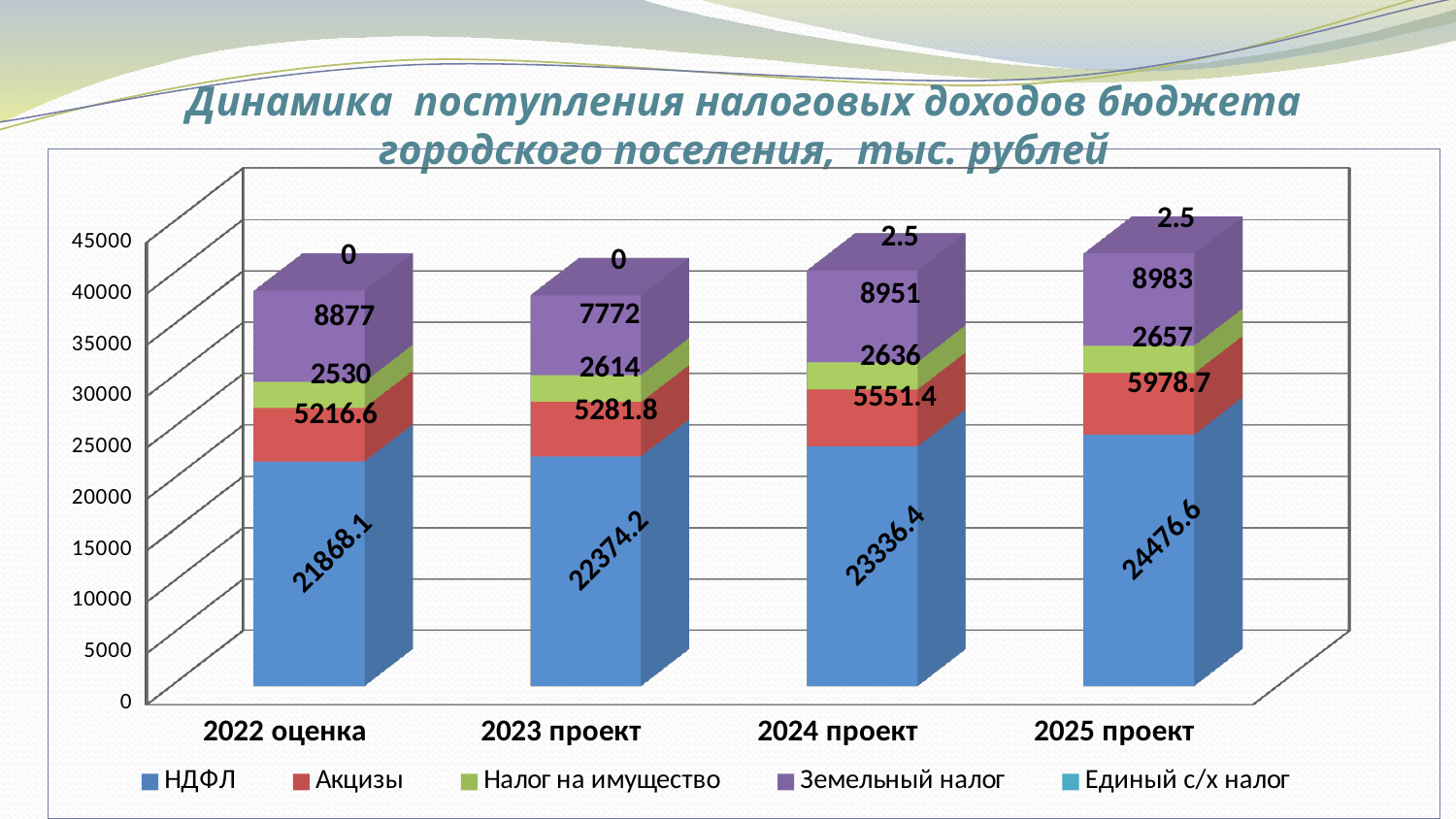
What is the difference between the НДФЛ values for 2025 проект and 2022 оценка? 2608.5 What is the Единый с/х налог value for 2023 проект? 0 What is the total of the stacked bar for 2024 проект? 40477.3 What is the НДФЛ value for 2022 оценка? 21868.1 Which year has the highest НДФЛ value? 2025 проект Which is larger, the Налог на имущество value for 2023 проект or for 2024 проект? 2024 проект Which year has the lowest Земельный налог value? 2023 проект What kind of chart is shown on the slide? Stacked bar chart How many categories are shown on the x axis? 4 How many series does the legend list? 5 What is the Акцизы value for 2025 проект? 5978.7 What is the Земельный налог value for 2024 проект? 8951